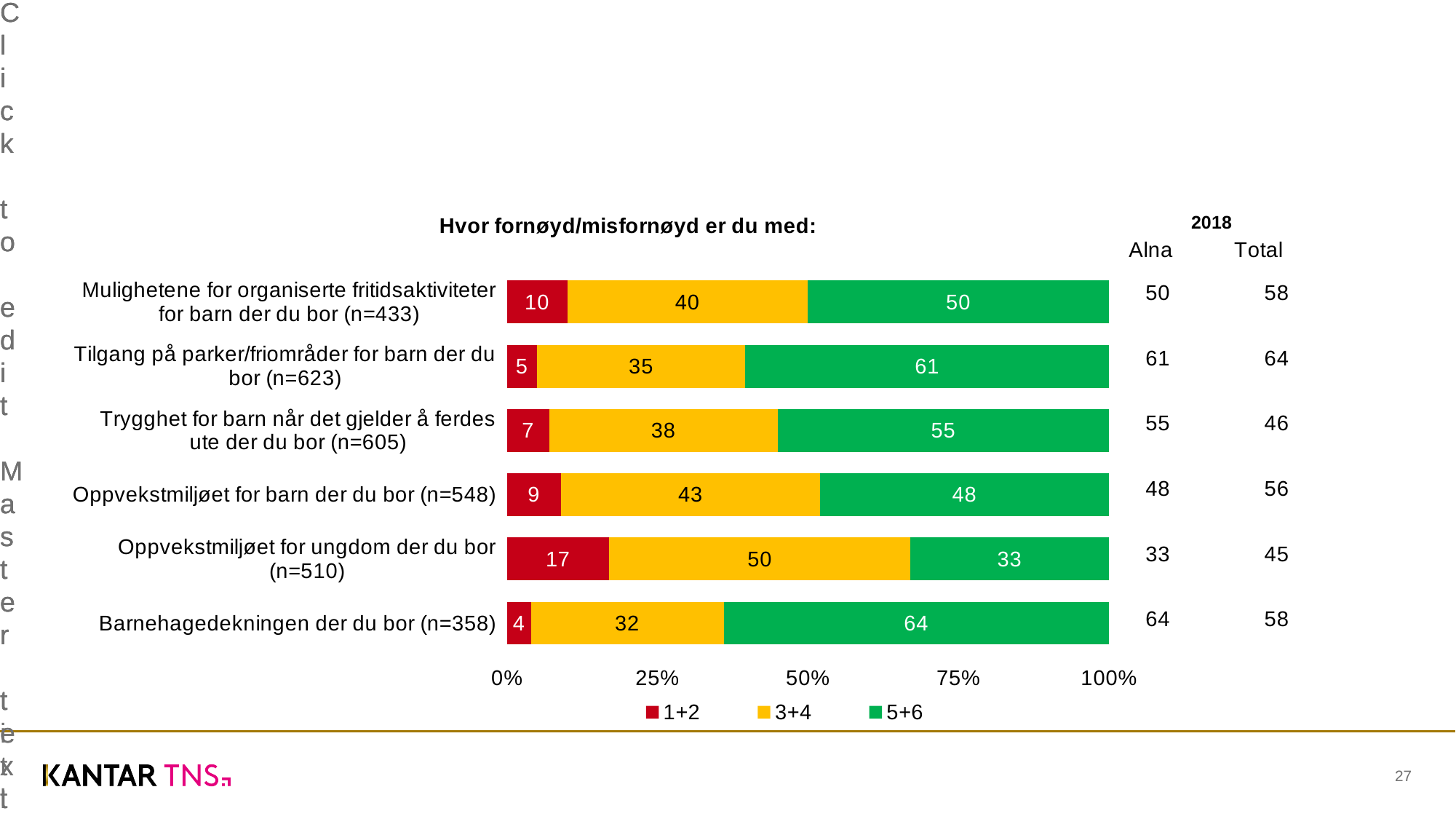
Which is larger: the 3+4 value for "Oppvekstmiljøet for ungdom der du bor (n=510)" or the 3+4 value for "Mulighetene for organiserte fritidsaktiviteter for barn der du bor (n=433)"? Oppvekstmiljøet for ungdom der du bor (n=510) What is the value of the 5+6 series for "Barnehagedekningen der du bor (n=358)"? 64 Which category has the highest value in the 5+6 series? Barnehagedekningen der du bor (n=358) What is the total of the stacked bar for "Trygghet for barn når det gjelder å ferdes ute der du bor (n=605)"? 100 Which category has the lowest value in the 1+2 series? Barnehagedekningen der du bor (n=358) What is the difference between the 5+6 values for "Tilgang på parker/friområder for barn der du bor (n=623)" and "Oppvekstmiljøet for ungdom der du bor (n=510)"? 28 What kind of chart is shown on the slide? Stacked bar chart What is the value of the 1+2 series for "Oppvekstmiljøet for ungdom der du bor (n=510)"? 17 What is the value of the 3+4 series for "Oppvekstmiljøet for barn der du bor (n=548)"? 43 How many series does the legend list? 3 What is the title of the chart? Hvor fornøyd/misfornøyd er du med: How many categories are shown in the chart? 6